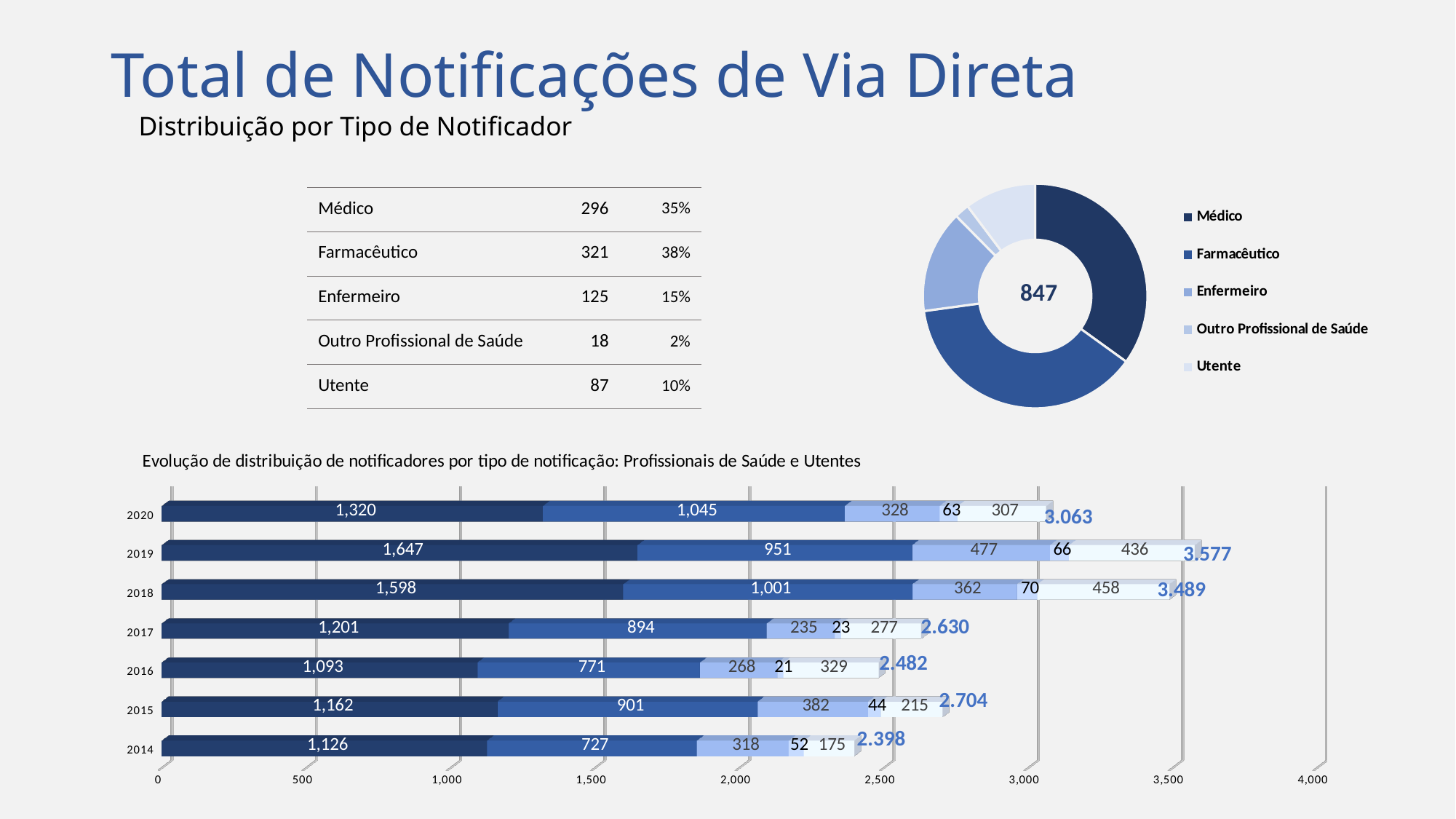
What kind of chart is the lower chart showing the years 2014 to 2020? Stacked bar chart In the donut chart, which category has the smallest share? Outro Profissional de Saúde In the lower bar chart, which year has the lowest total? 2014 What number is shown in the centre of the donut chart? 847 In the lower bar chart, what is the value of the first (darkest blue) segment of the 2018 bar? 1,598 In the donut chart, what percentage share does Farmacêutico have? 38% How many categories does the donut chart's legend list? 5 In the lower bar chart, which year has the highest total? 2019 In the table next to the donut chart, what is the value for Enfermeiro? 125 In the donut chart, which category has the largest share? Farmacêutico In the lower bar chart, what is the total shown at the end of the 2019 bar? 3.577 How many years are shown in the lower bar chart? 7